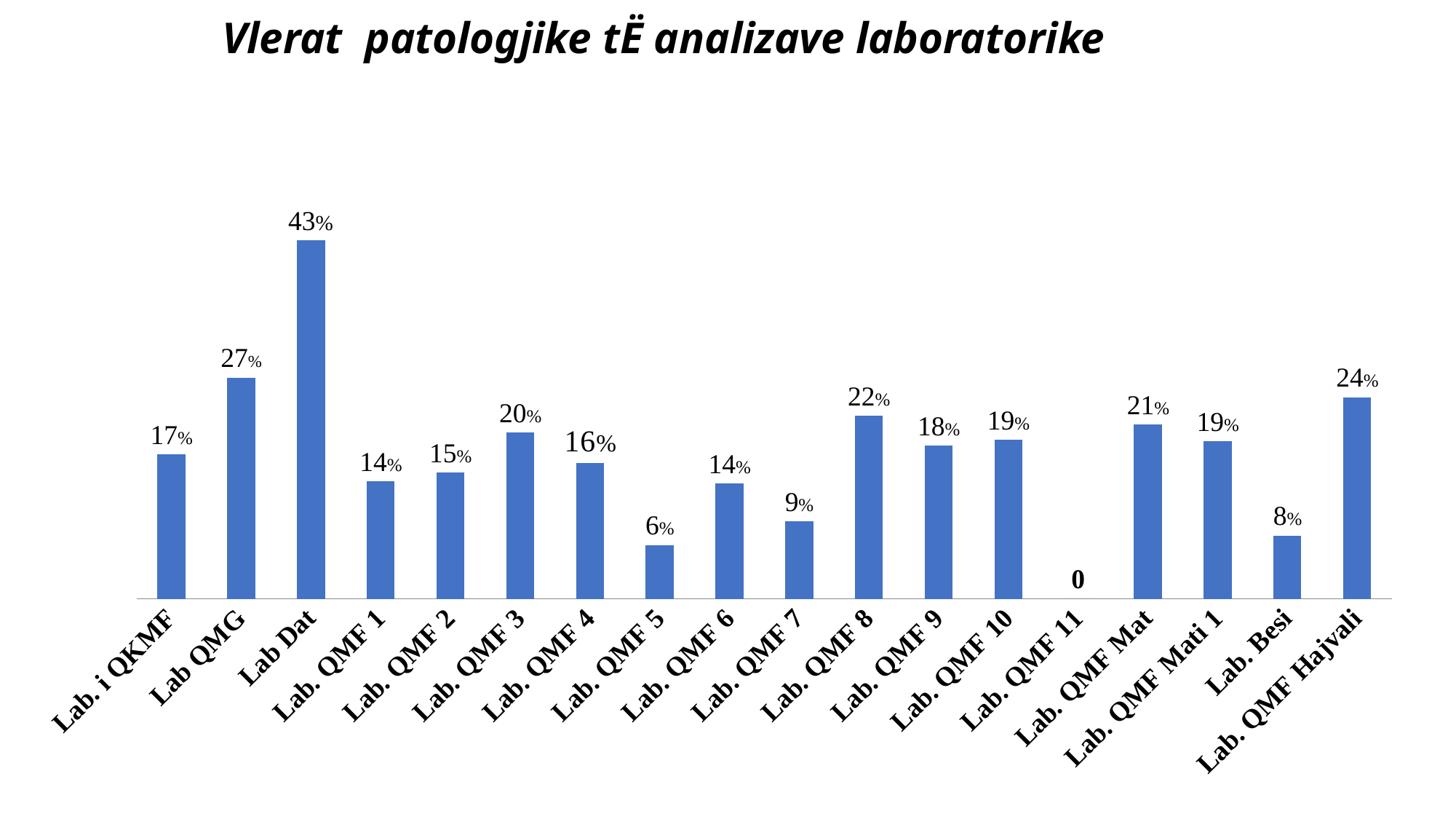
What is the difference between the values for Lab. QMF 8 and Lab. QMF 7? 13% Which laboratory has the lowest value? Lab. QMF 11 What is the difference between the values for Lab Dat and Lab QMG? 16% What is the value for Lab Dat? 43% What is the value shown for Lab. QMF 11? 0 How many laboratories are shown on the chart? 18 What is the value for Lab. QMF 5? 6% What is the value for Lab. QMF Hajvali? 24% Which is larger, the value for Lab. QMF Mat or the value for Lab. Besi? Lab. QMF Mat What kind of chart is shown on the slide? Bar chart Which laboratory has the highest value? Lab Dat What is the title of the chart? Vlerat patologjike tË analizave laboratorike